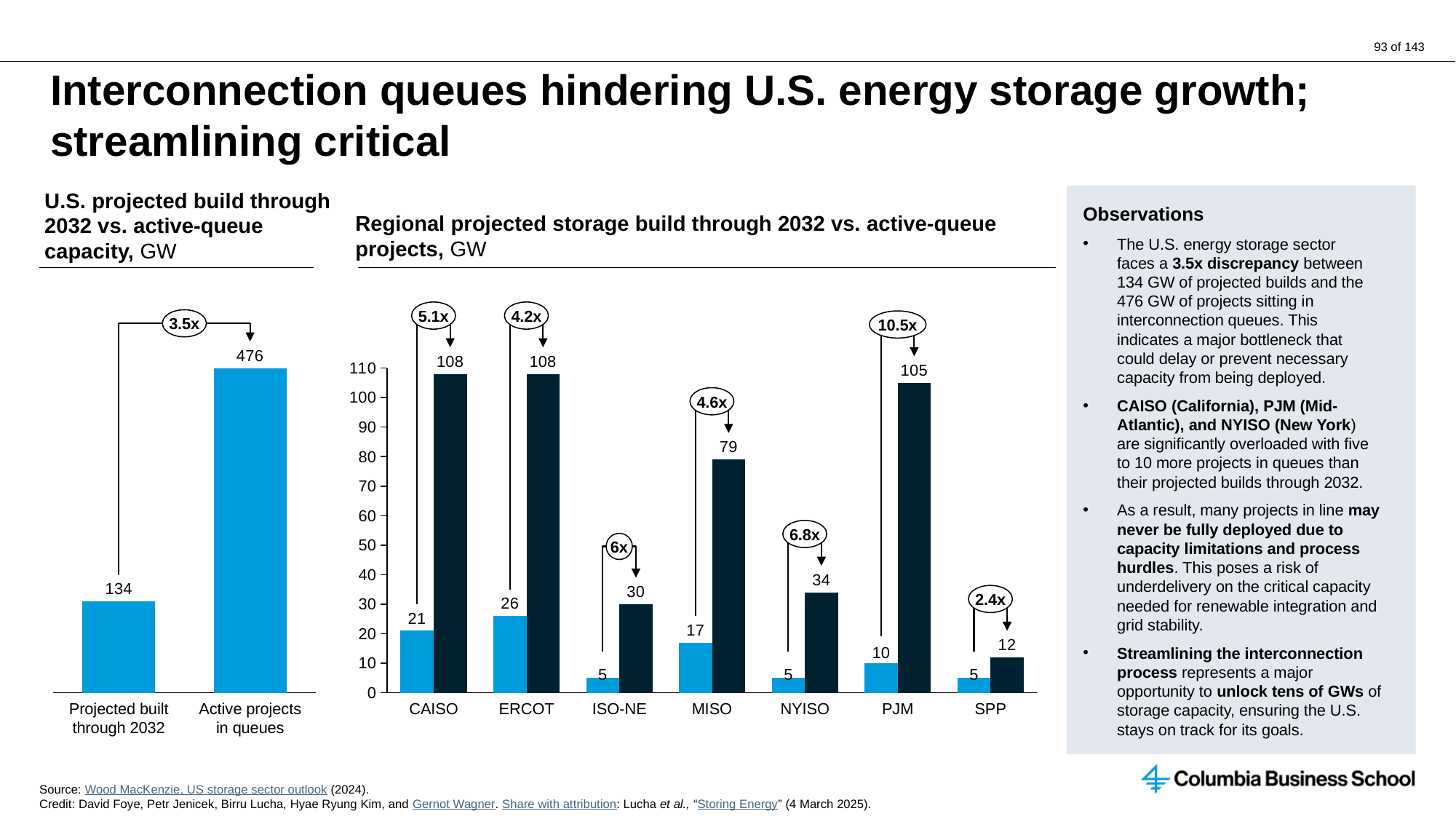
In the left chart (U.S. projected build through 2032 vs. active-queue capacity), what is the value for Projected built through 2032? 134 In the left chart (U.S. projected build through 2032 vs. active-queue capacity), what multiplier is shown in the oval above the bars? 3.5x In the right chart (Regional projected storage build through 2032 vs. active-queue projects), what is the difference between the dark bar and the light blue bar for MISO? 62 In the right chart (Regional projected storage build through 2032 vs. active-queue projects), which region has the highest light blue bar (projected build)? ERCOT In the left chart (U.S. projected build through 2032 vs. active-queue capacity), what is the value for Active projects in queues? 476 What kind of chart is the right chart (Regional projected storage build through 2032 vs. active-queue projects)? Bar chart In the right chart (Regional projected storage build through 2032 vs. active-queue projects), what is the value of the light blue bar (projected build) for ERCOT? 26 In the right chart (Regional projected storage build through 2032 vs. active-queue projects), how many regions are shown on the x axis? 7 In the right chart (Regional projected storage build through 2032 vs. active-queue projects), which region has the lowest dark bar (active-queue projects)? SPP In the right chart (Regional projected storage build through 2032 vs. active-queue projects), which is larger: the dark bar for NYISO or the dark bar for ISO-NE? NYISO In the right chart (Regional projected storage build through 2032 vs. active-queue projects), what is the value of the dark bar (active-queue projects) for PJM? 105 In the left chart (U.S. projected build through 2032 vs. active-queue capacity), what is the difference between Active projects in queues and Projected built through 2032? 342